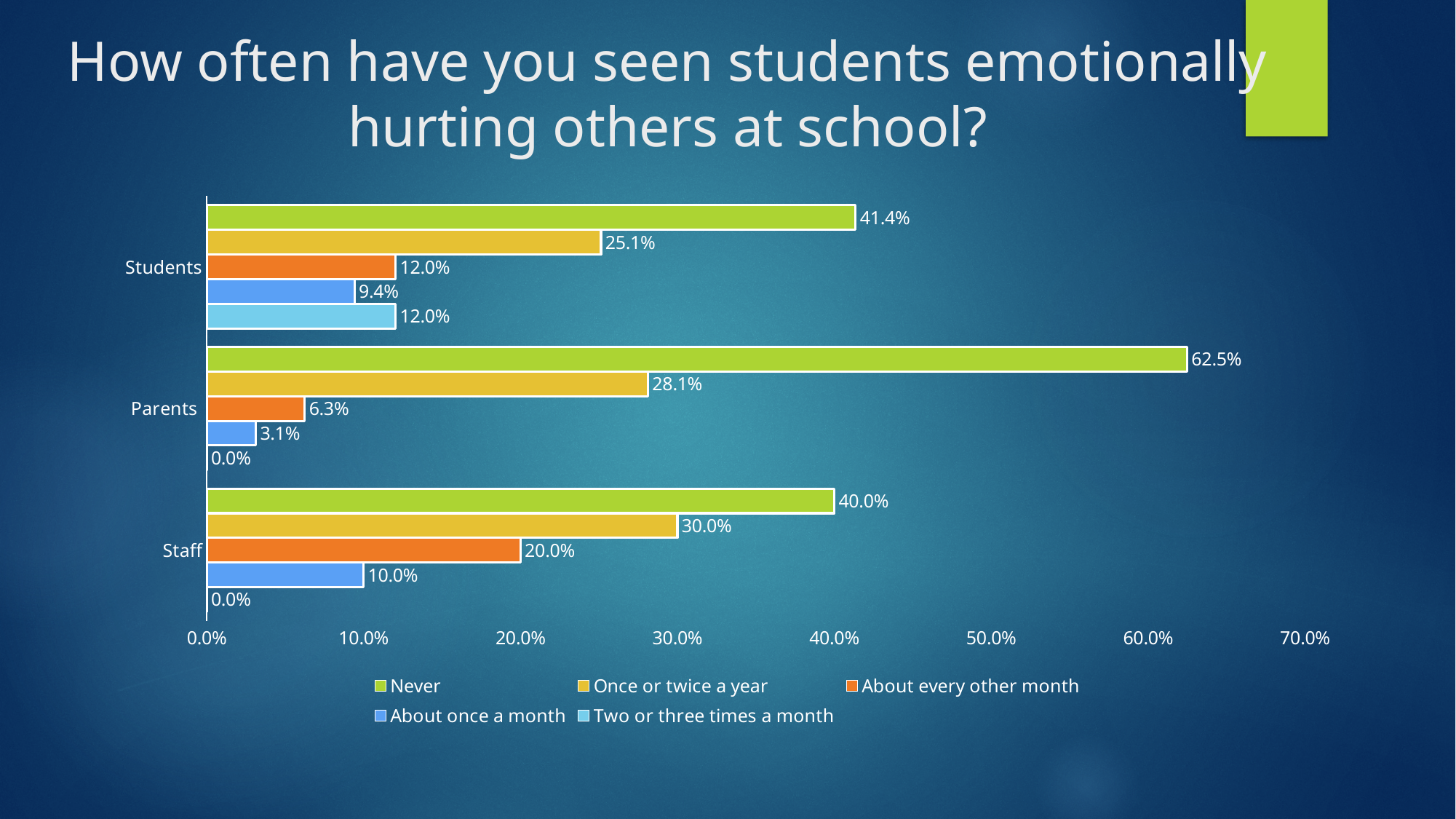
What percentage of Parents answered "About once a month"? 3.1% Which is larger: the "Once or twice a year" value for Staff or for Parents? Staff Which group has the highest percentage for "Never"? Parents What percentage of Parents answered "Never"? 62.5% What percentage of Staff answered "About every other month"? 20.0% What percentage of Students answered "Once or twice a year"? 25.1% How many groups are shown on the y axis? 3 What kind of chart is shown on the slide? Bar chart Which group has the lowest percentage for "About every other month"? Parents Is the "Never" value for Parents greater or less than 60.0%? greater How many series does the legend list? 5 What is the difference between the "Never" percentages for Parents and Students? 21.1%